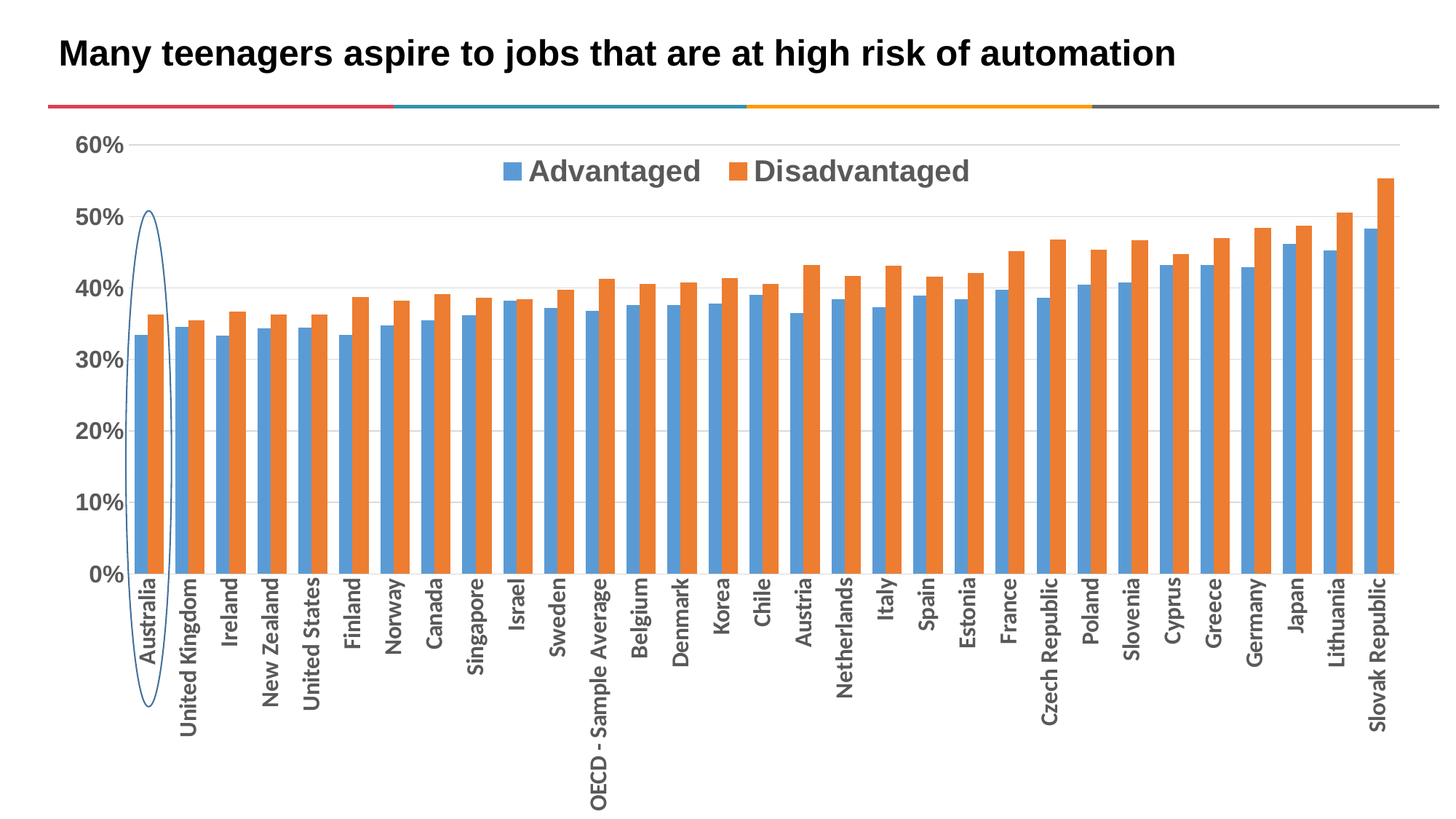
Which is larger: the Advantaged value for Japan or the Advantaged value for Australia? Japan Is the Disadvantaged value for Slovak Republic greater or less than 50%? greater Do the Disadvantaged values generally rise or fall from left to right along the x axis? Rise How many series does the legend list? 2 What kind of chart is shown on the slide? Bar chart Which category has the highest Advantaged value? Slovak Republic How many countries/categories are shown on the x axis? 31 Which category has the highest Disadvantaged value? Slovak Republic For Finland, which is larger: the Advantaged or the Disadvantaged value? Disadvantaged Is the Advantaged value for Germany greater or less than 40%? greater Is the Advantaged value for Australia greater or less than 30%? greater